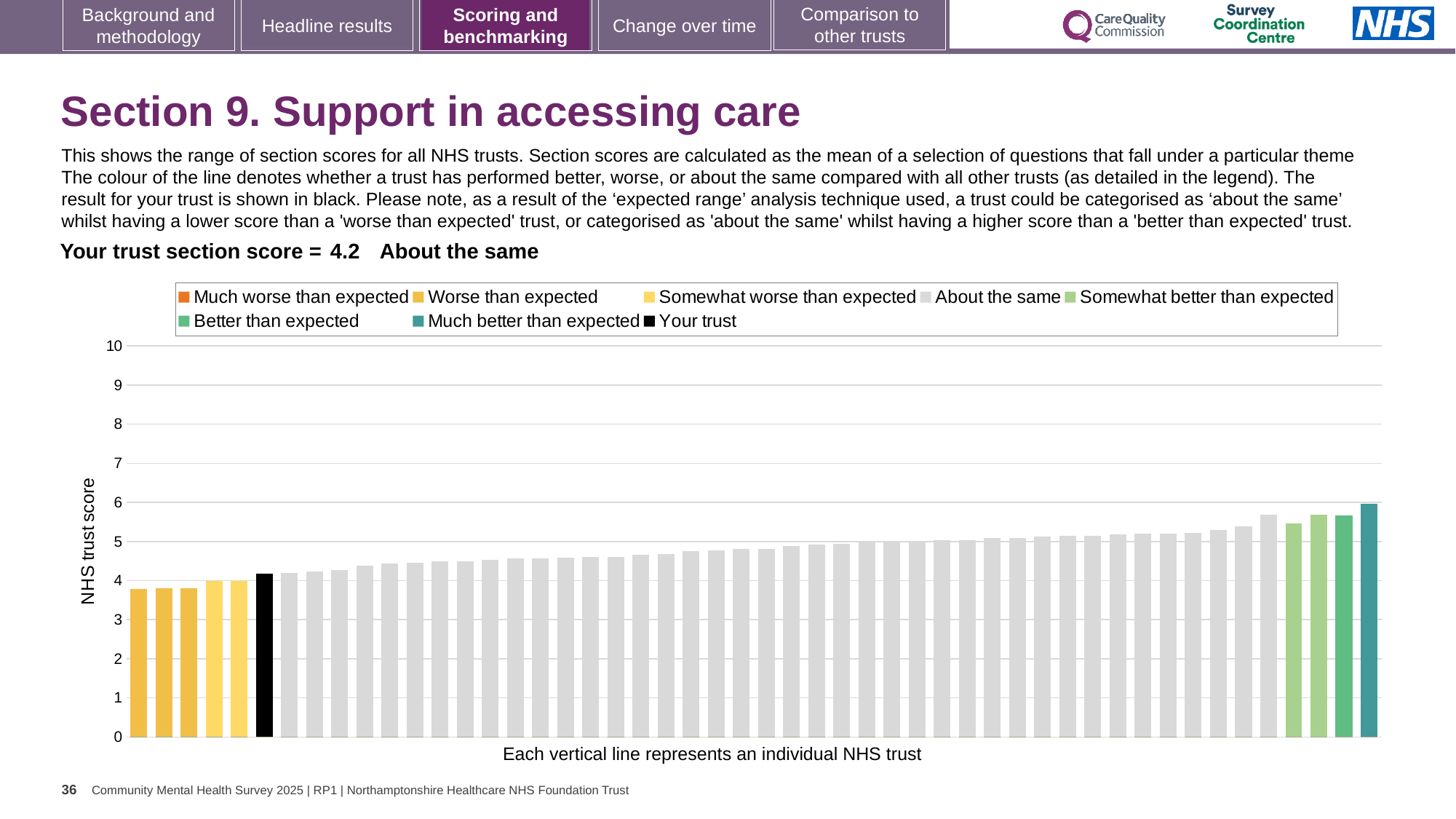
Do the trust scores rise or fall from left to right along the x axis? rise Is the value of the rightmost bar greater or less than 7? less What is the section score for your trust shown on the slide? 4.2 Is the value of the leftmost bar greater or less than 5? less What is the highest value shown on the y axis? 10 Is the value for your trust (the black bar) greater or less than 5? less Which bar is taller: the black bar for your trust or the rightmost teal bar? the rightmost teal bar How many entries does the chart legend list? 8 What is the label on the y axis of the chart? NHS trust score What type of chart is used to show the NHS trust scores? bar chart Which legend category does the black bar represent? Your trust